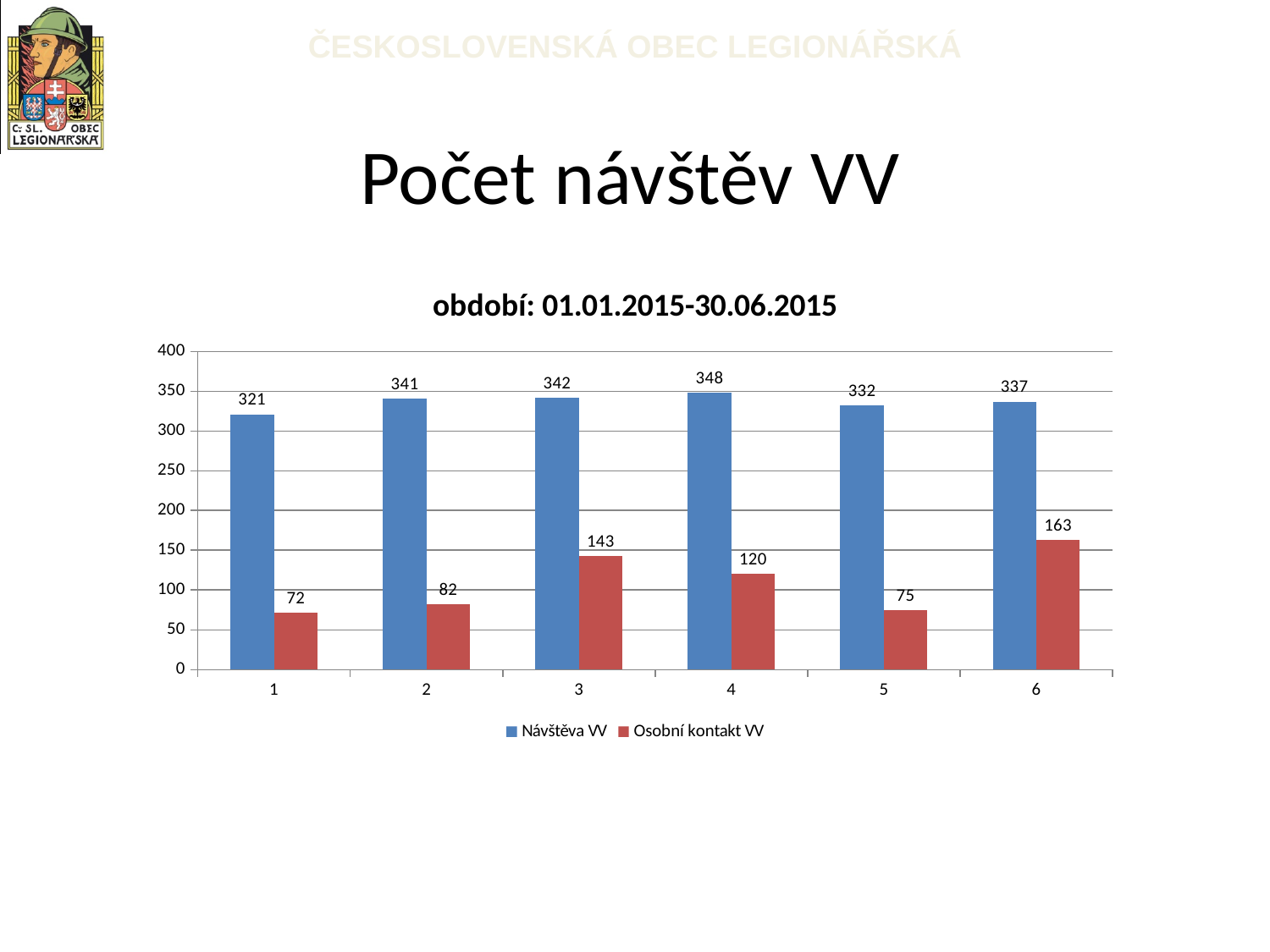
What is the value of Osobní kontakt VV for category 2? 82 Which is larger: Osobní kontakt VV for category 4 or for category 5? category 4 What is the value of Návštěva VV for category 4? 348 Which category has the highest Návštěva VV value? 4 What is the difference between Návštěva VV for category 2 and category 1? 20 How many categories are shown on the x axis? 6 What kind of chart is shown on the slide? bar chart Which category has the lowest Osobní kontakt VV value? 1 What is the difference between Návštěva VV and Osobní kontakt VV for category 3? 199 What is the value of Osobní kontakt VV for category 6? 163 How many series does the legend list? 2 What is the chart's title? období: 01.01.2015-30.06.2015